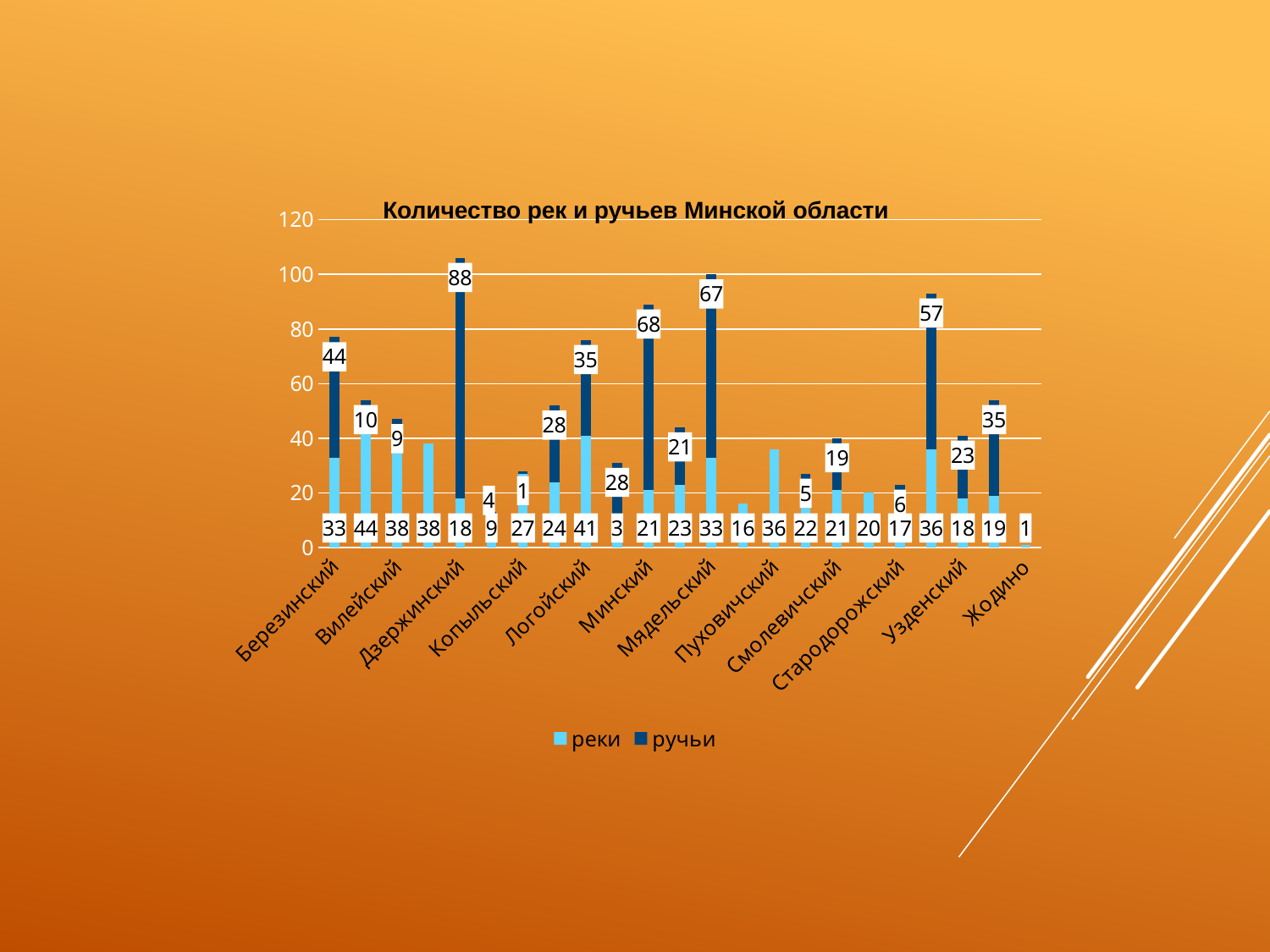
Is the total stacked bar for Дзержинский greater or less than 100? greater What are the two series named in the legend? реки and ручьи How many series does the legend list? 2 What kind of chart is shown on the slide? stacked bar chart What is the title of the chart? Количество рек и ручьев Минской области What is the difference between ручьи and реки for Минский? 47 Which labelled district has the highest value of ручьи? Дзержинский What is the value of реки for Жодино? 1 What is the value of реки for Логойский? 41 What is the value of ручьи for Дзержинский? 88 Which is larger for Березинский, реки or ручьи? ручьи What is the total of the stacked bar for Мядельский (реки plus ручьи)? 100